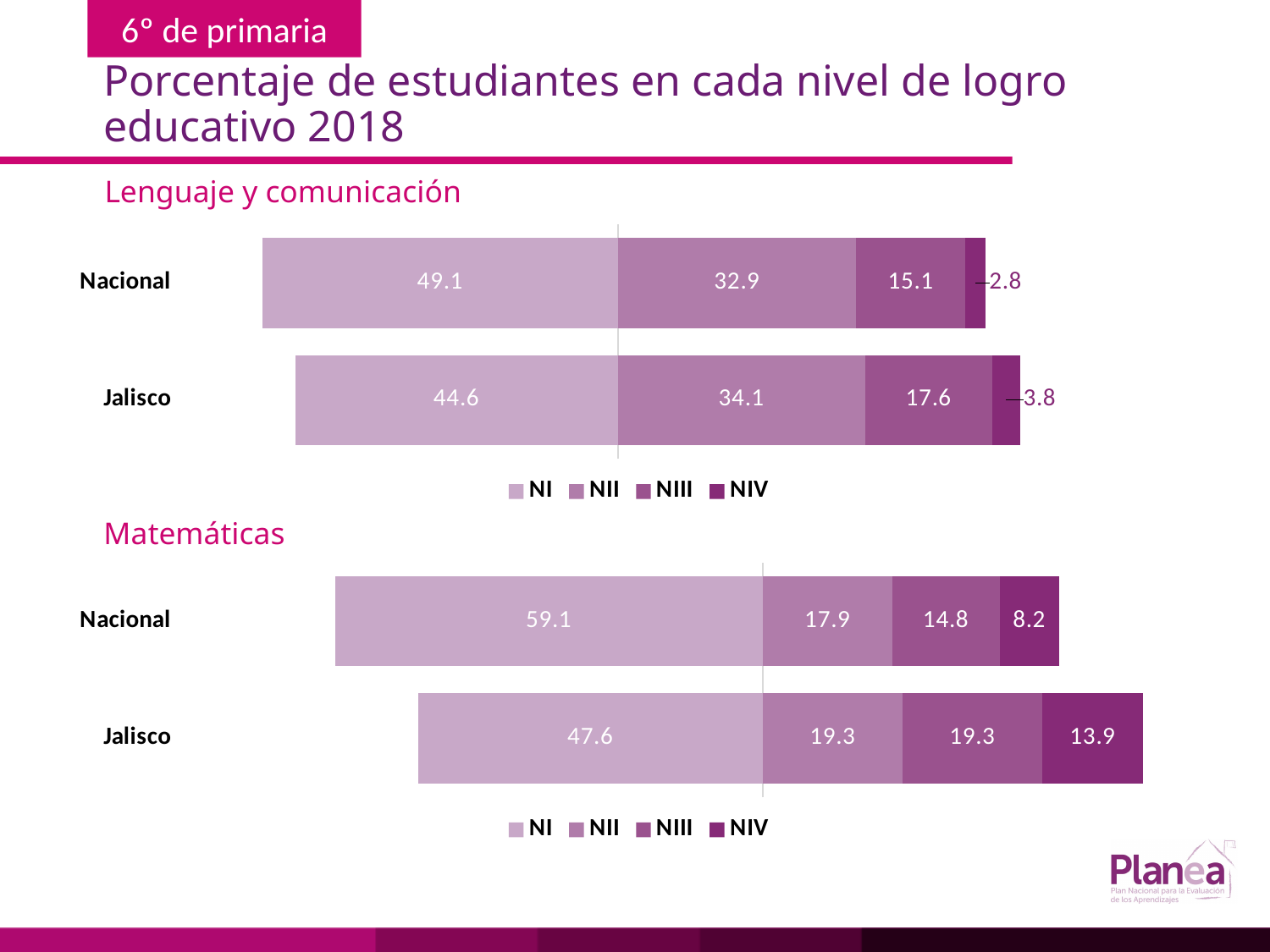
In the Matemáticas chart, what is the NIV value for Nacional? 8.2 In the Matemáticas chart, which series has the highest value for Jalisco? NI How many series does the legend of the Matemáticas chart list? 4 In the Matemáticas chart, what is the NI value for Jalisco? 47.6 In the Matemáticas chart, which is larger, the NIV value for Jalisco or for Nacional? Jalisco In the Lenguaje y comunicación chart, what is the difference between the NIII values for Jalisco and Nacional? 2.5 In the Lenguaje y comunicación chart, what is the NI value for Nacional? 49.1 In the Lenguaje y comunicación chart, which series has the lowest value for Nacional? NIV What kind of chart is the Lenguaje y comunicación chart? Stacked bar chart In the Matemáticas chart, what is the difference between the NI values for Nacional and Jalisco? 11.5 In the Lenguaje y comunicación chart, what is the NIV value for Jalisco? 3.8 In the Matemáticas chart, what is the total of the Nacional bar? 100.0